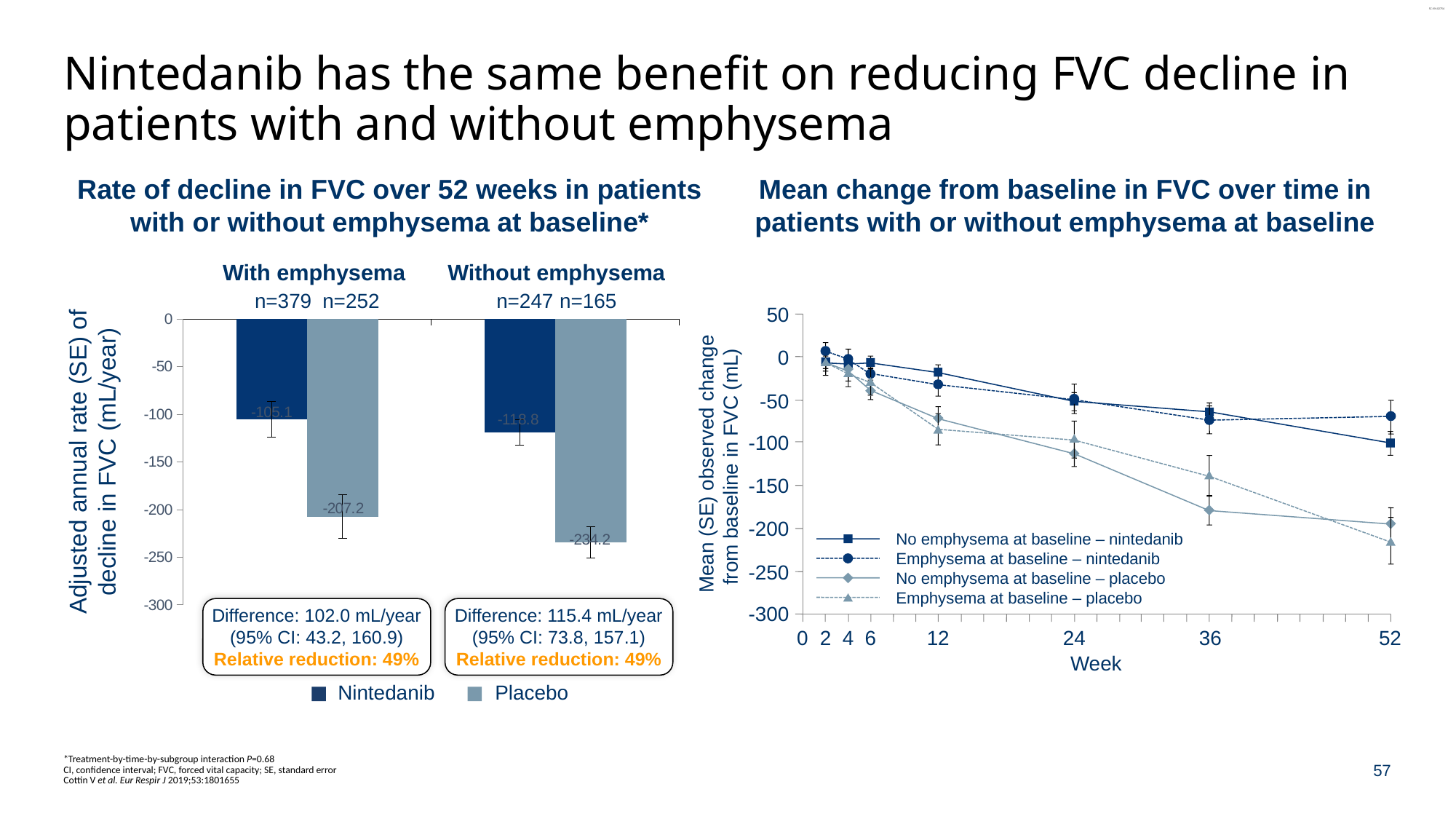
In the left chart (Rate of decline in FVC over 52 weeks), which bar shows the largest decline in FVC? Placebo, without emphysema In the left chart (Rate of decline in FVC over 52 weeks), what is the value for nintedanib in patients without emphysema? -118.8 In the right chart (Mean change from baseline in FVC over time), how many series does the legend list? 4 In the left chart (Rate of decline in FVC over 52 weeks), what is the difference between the placebo and nintedanib values in patients with emphysema? 102.1 In the right chart (Mean change from baseline in FVC over time), do the values for 'Emphysema at baseline – placebo' rise or fall from week 0 to week 52? Fall In the left chart (Rate of decline in FVC over 52 weeks), which shows a greater decline: nintedanib with emphysema or nintedanib without emphysema? Nintedanib without emphysema In the left chart (Rate of decline in FVC over 52 weeks), what is the adjusted annual rate of decline in FVC for placebo in patients without emphysema? -234.2 In the left chart (Rate of decline in FVC over 52 weeks), how many series does the legend list? 2 In the left chart (Rate of decline in FVC over 52 weeks), what is the value for placebo in patients with emphysema? -207.2 In the right chart (Mean change from baseline in FVC over time), is the value at week 52 for 'No emphysema at baseline – placebo' greater or less than -150? less In the left chart (Rate of decline in FVC over 52 weeks), what is the adjusted annual rate of decline in FVC for nintedanib in patients with emphysema? -105.1 What kind of chart is the left chart (Rate of decline in FVC over 52 weeks)? Bar chart